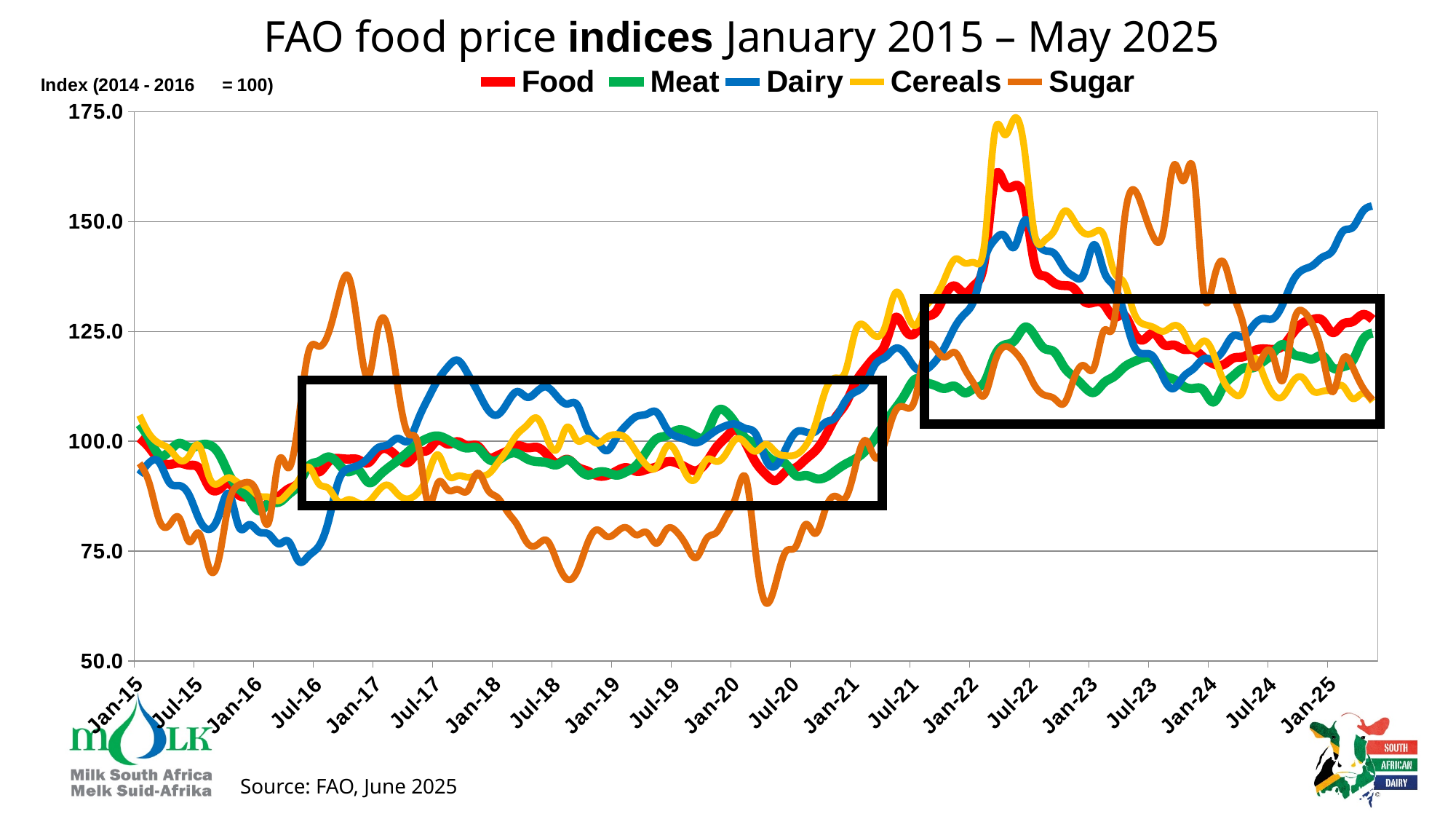
Does the Dairy index rise or fall between Jan-24 and May 2025? rise At Jan-25, which is larger, the Dairy index or the Cereals index? Dairy Which series is drawn in blue according to the legend? Dairy How many series does the legend list? 5 Which series reaches the highest value anywhere on the chart? Cereals Is the value of the Dairy index at the end of the chart (May 2025) greater or less than 150? greater At Jul-23, which is larger, the Sugar index or the Meat index? Sugar What kind of chart is shown on the slide? line chart What is the title of the chart? FAO food price indices January 2015 – May 2025 Is the value of the Cereals index at Jan-18 greater or less than 100? less Which series falls to the lowest value anywhere on the chart? Sugar